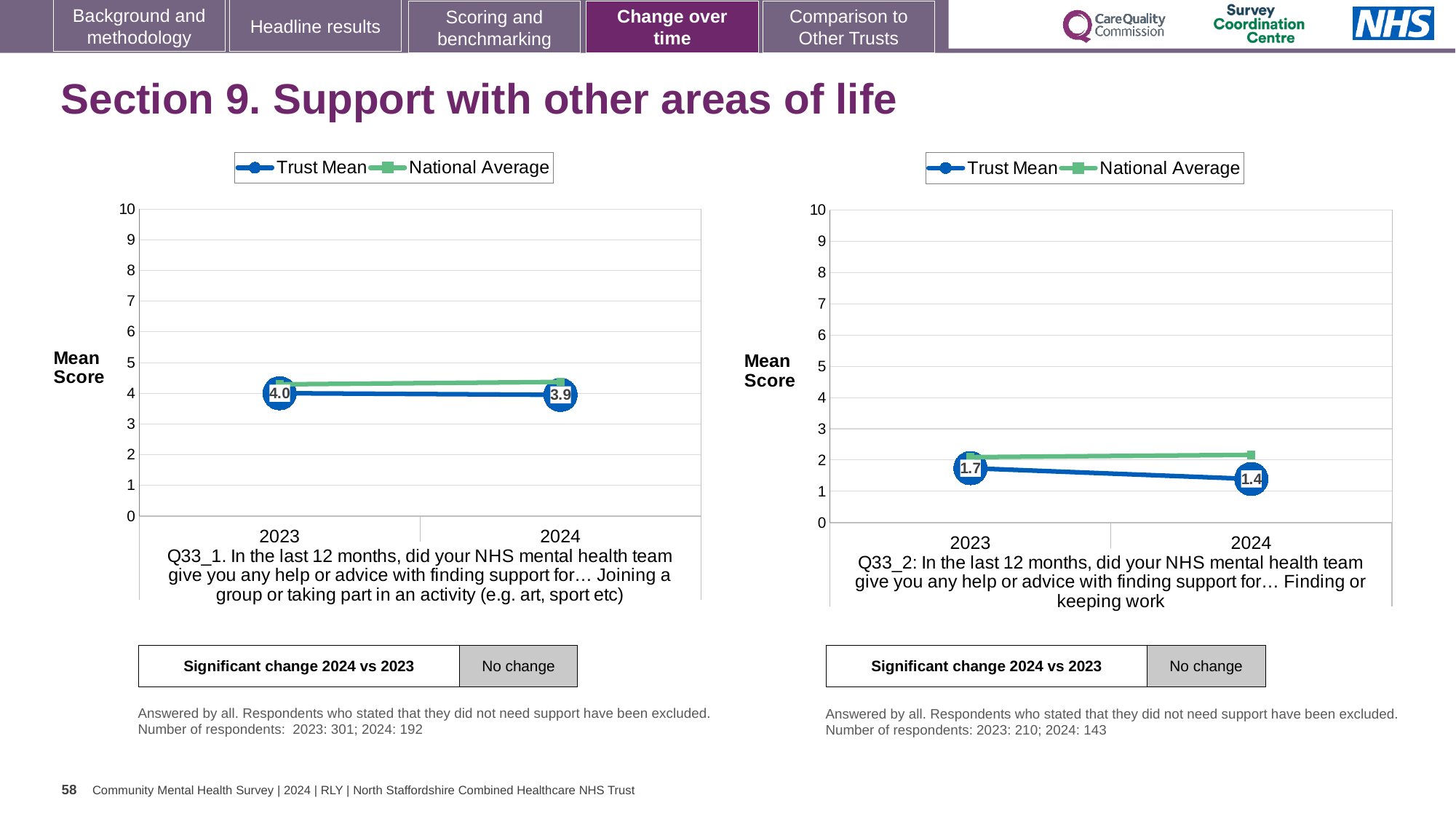
In the left chart (Q33_1), is the National Average for 2024 greater or less than 4? greater In the right chart (Q33_2), does the Trust Mean rise or fall from 2023 to 2024? fall In the right chart (Q33_2), what is the Trust Mean for 2024? 1.4 In the left chart (Q33_1), what is the Trust Mean for 2023? 4.0 How many series does the legend of the left chart list? 2 In the right chart (Q33_2), what is the Trust Mean for 2023? 1.7 In the left chart (Q33_1), what is the difference between the Trust Mean in 2023 and 2024? 0.1 In the right chart (Q33_2), by how much did the Trust Mean change from 2023 to 2024? 0.3 In the right chart (Q33_2), is the National Average for 2023 greater or less than 3? less In the left chart (Q33_1), what is the Trust Mean for 2024? 3.9 What type of chart is used on the right side of the slide (Q33_2)? line chart In the right chart (Q33_2), which is higher in 2024, the Trust Mean or the National Average? National Average